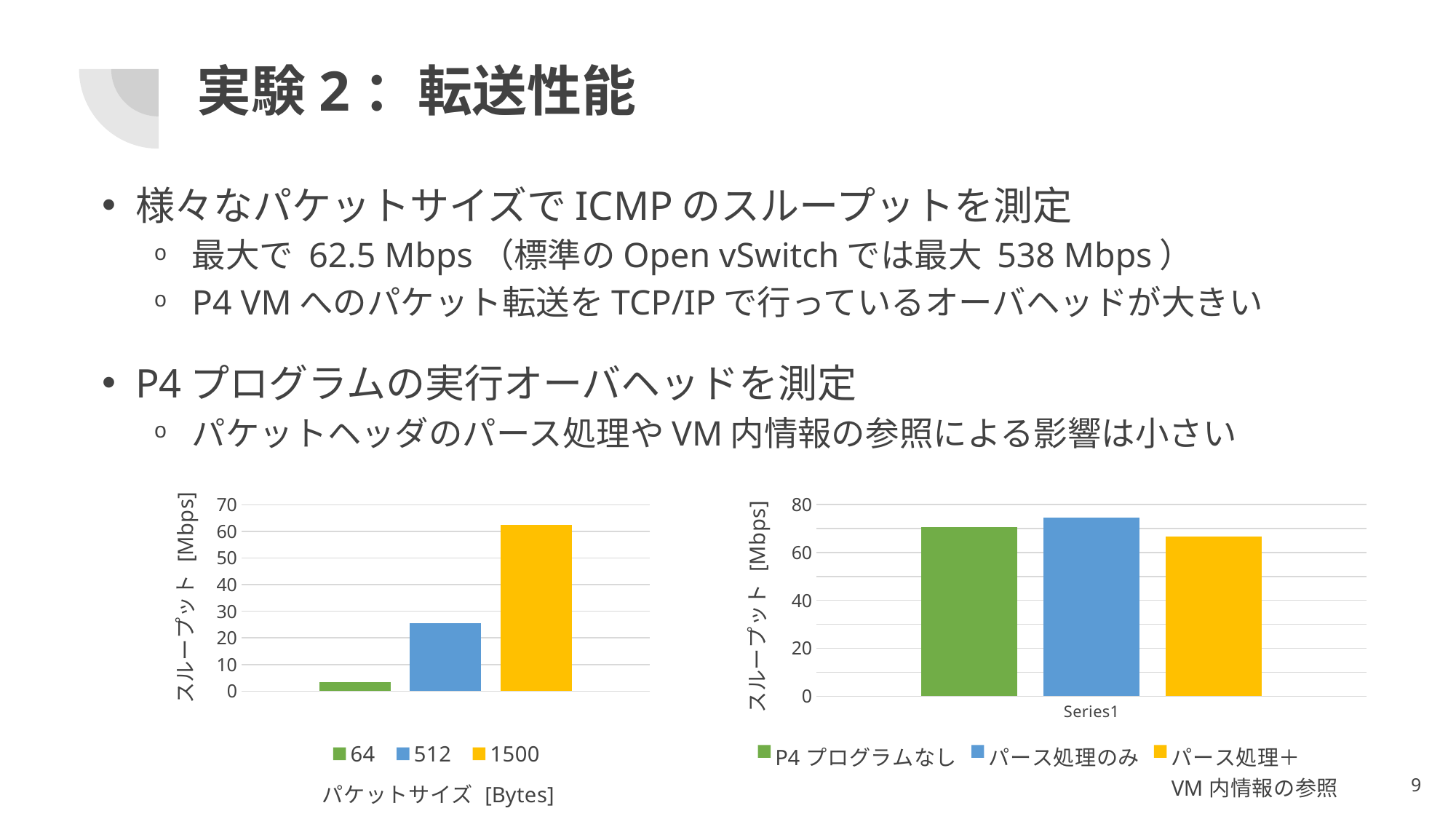
In the right chart (P4 program overhead), which series has the highest throughput? パース処理のみ In the right chart (P4 program overhead), which series has the lowest throughput? パース処理＋VM 内情報の参照 In the left chart (throughput vs packet size), which packet size has the lowest throughput? 64 In the right chart (P4 program overhead), is the throughput for P4 プログラムなし greater or less than 60 Mbps? greater In the left chart (throughput vs packet size), how many series does the legend list? 3 In the right chart (P4 program overhead), what is the label on the vertical axis? スループット [Mbps] In the left chart (throughput vs packet size), is the throughput for packet size 64 greater or less than 10 Mbps? less In the left chart (throughput vs packet size), is the throughput for packet size 512 greater or less than 30 Mbps? less In the left chart (throughput vs packet size), which packet size has the highest throughput? 1500 In the left chart (throughput vs packet size), does throughput rise or fall as packet size increases from 64 to 1500? rise What kind of chart is the left chart (throughput vs packet size)? bar chart